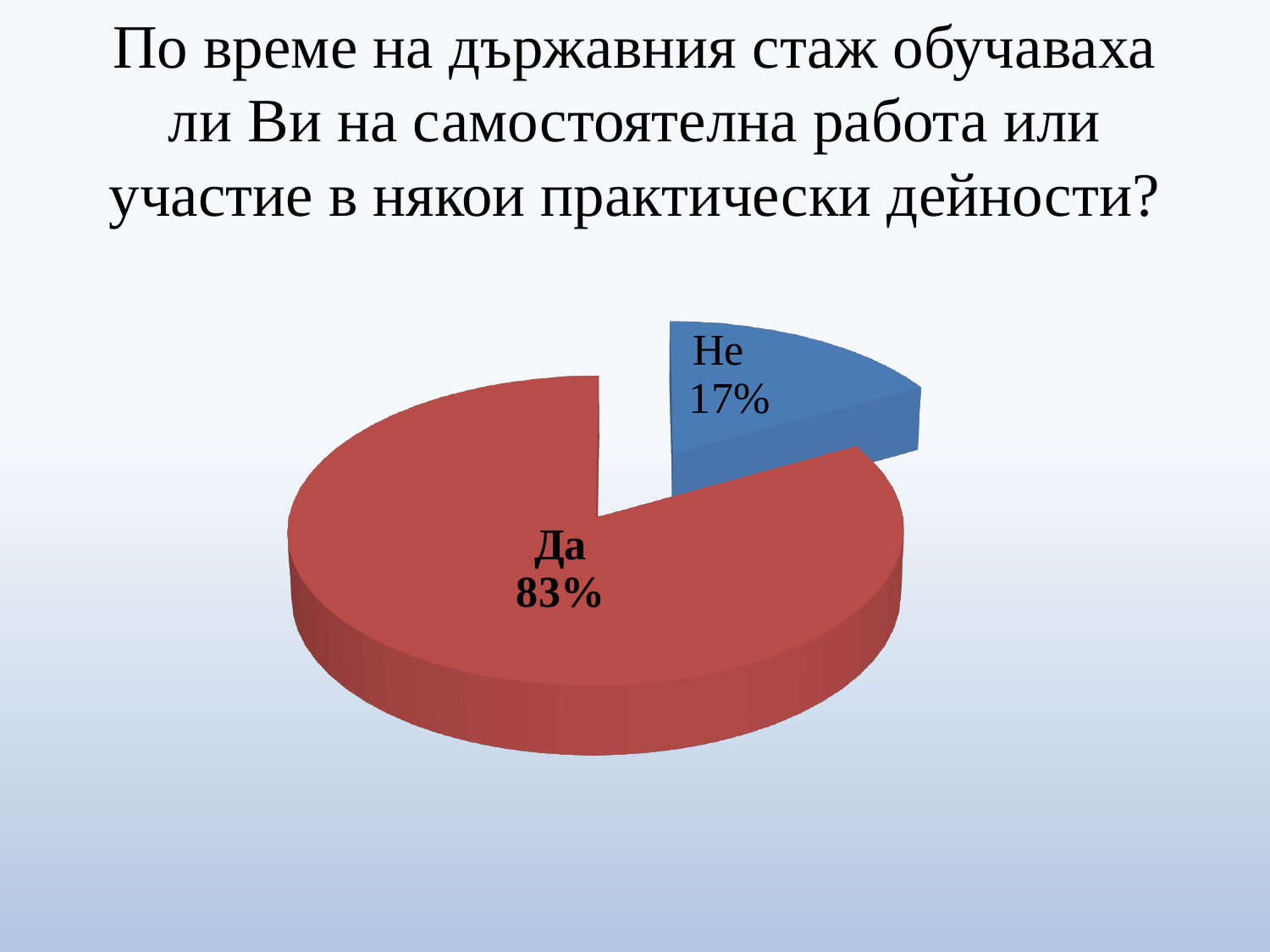
Which slice is the smallest? Не What share of the pie does the "Да" slice represent? 83% What share of the pie does the "Не" slice represent? 17% What colour is the "Да" slice? red What is the difference in percentage points between the "Да" and "Не" slices? 66 How many slices does the pie chart have? 2 What kind of chart is shown on the slide? pie chart Which is larger, the "Да" slice or the "Не" slice? Да What colour is the "Не" slice? blue Which slice is the largest? Да